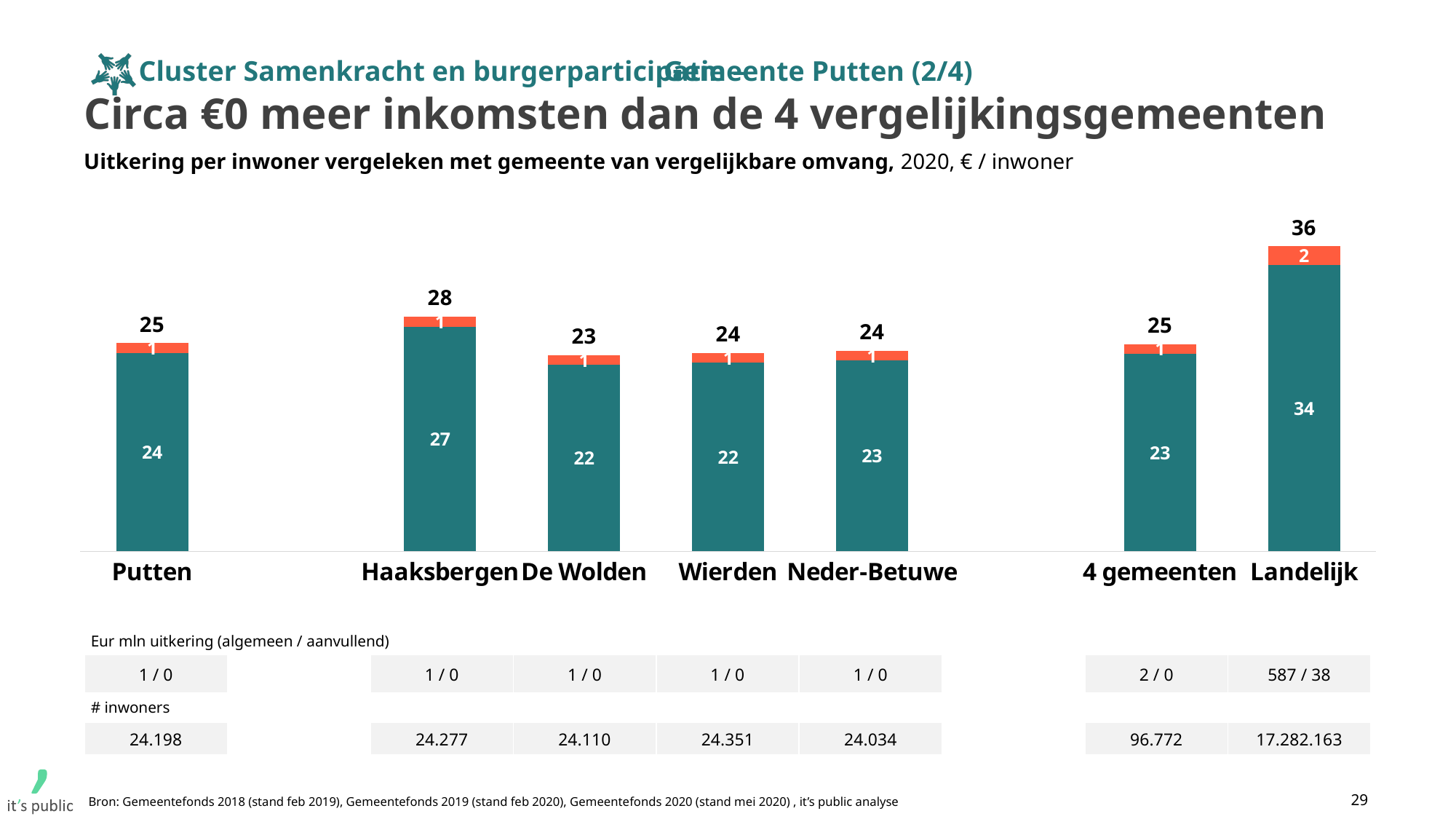
What is the value of the orange (upper) segment for Landelijk? 2 Which category has the lowest total value? De Wolden How many categories are shown on the x axis? 7 What is the difference between the total for Landelijk and the total for Putten? 11 Which category has the highest total value? Landelijk What is the value of the teal (lower) segment for Haaksbergen? 27 Which has a larger total value, Haaksbergen or Neder-Betuwe? Haaksbergen What is the total value shown above the bar for Landelijk? 36 What is the value of the teal (lower) segment for Putten? 24 What kind of chart is shown on the slide? Stacked bar chart What is the total value shown above the bar for Haaksbergen? 28 What is the number of inhabitants (# inwoners) listed for Wierden below the chart? 24.351